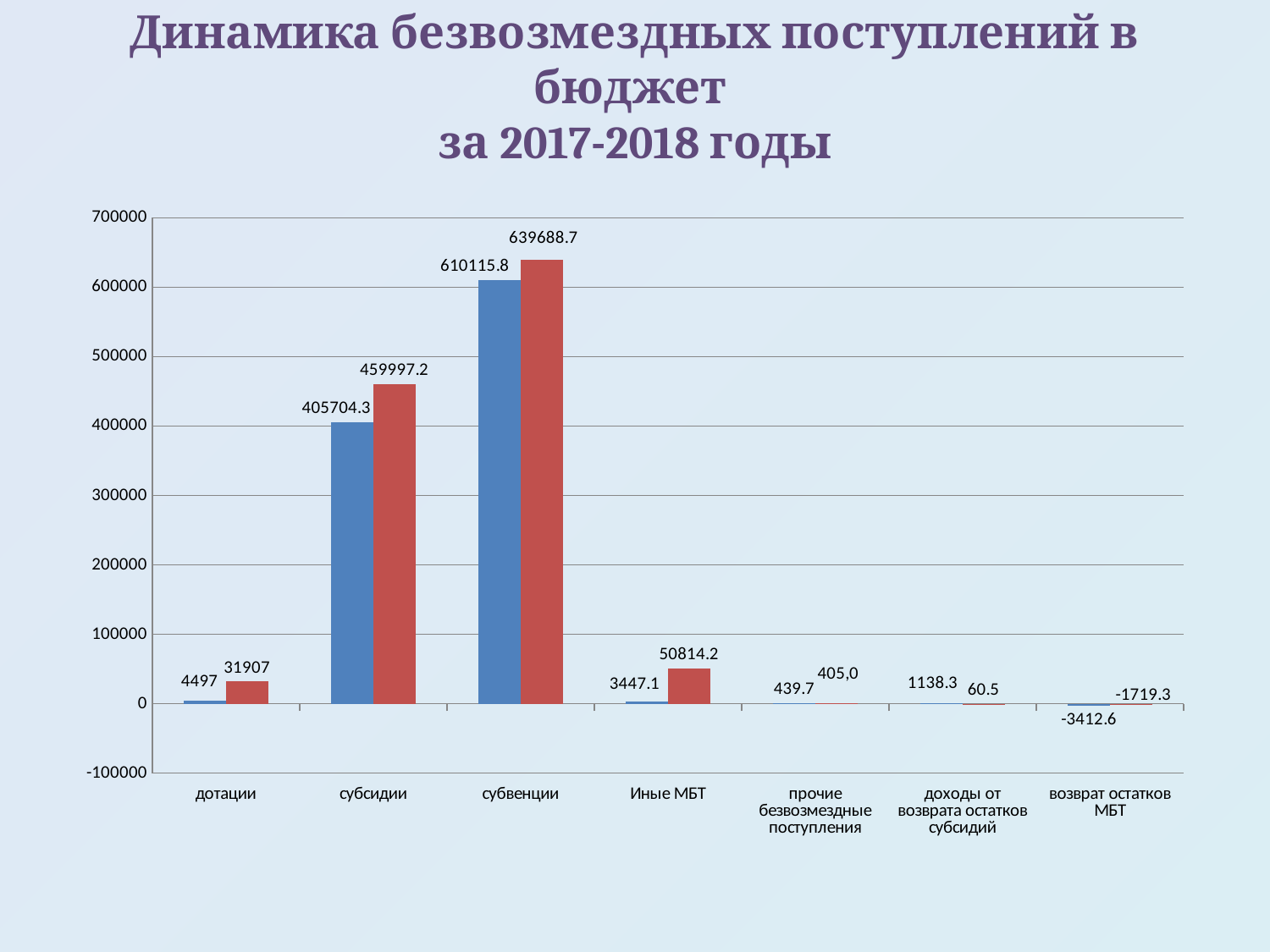
What is the difference between the red and blue bars for субсидии? 54292.9 Which category has the highest bar in the chart? субвенции What kind of chart is shown on the slide? bar chart What is the value of the red bar for субвенции? 639688.7 Which category has the lowest (most negative) value in the chart? возврат остатков МБТ How many categories are shown on the x axis of the chart? 7 Is the value of the red bar for субсидии greater or less than 400000? greater What is the value of the red bar for Иные МБТ? 50814.2 What is the difference between the red and blue bars for дотации? 27410 What is the value of the blue bar for возврат остатков МБТ? -3412.6 For доходы от возврата остатков субсидий, which bar is larger, the blue or the red? blue What is the value of the blue bar for субсидии? 405704.3